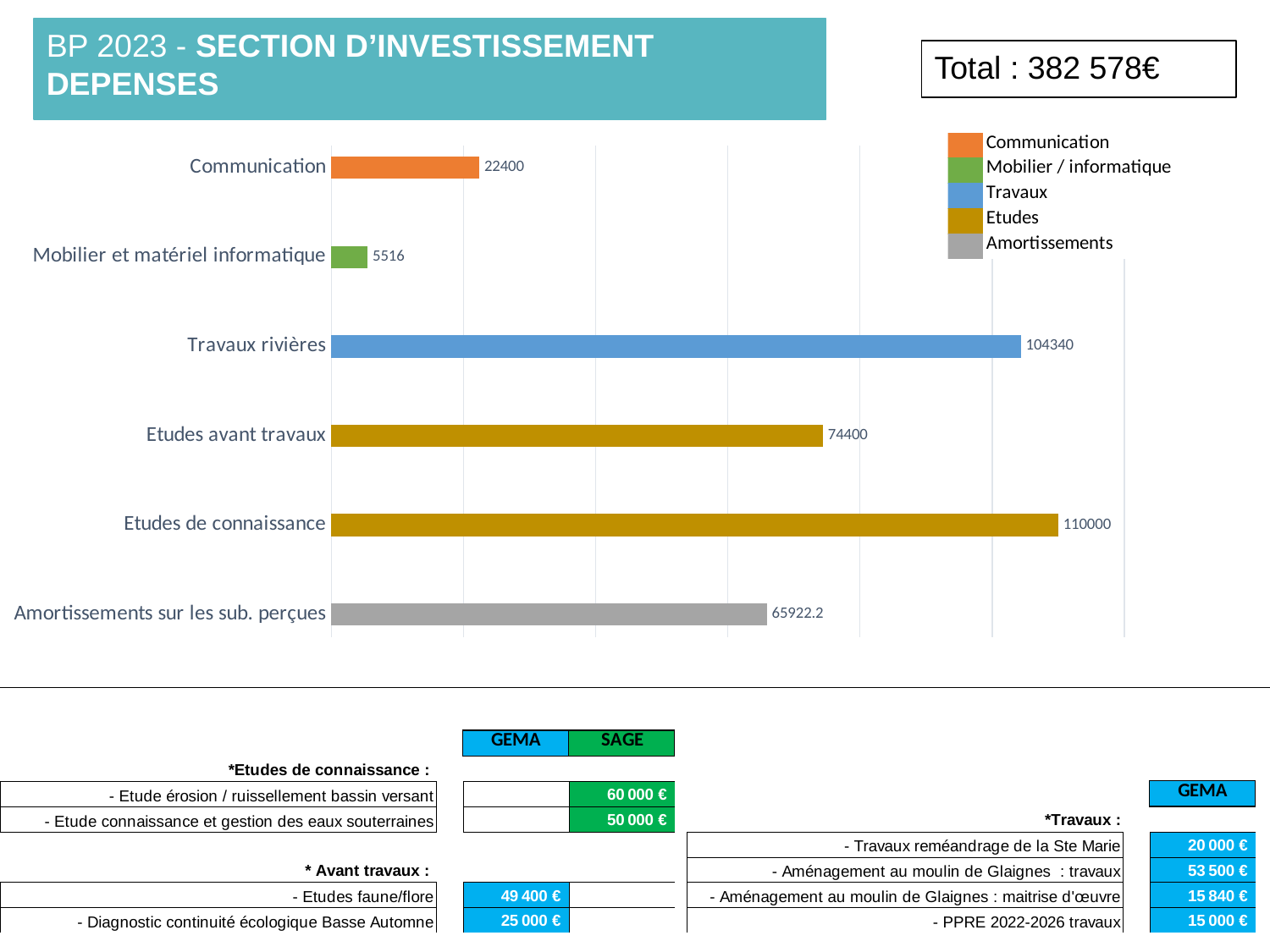
What is the value for Travaux rivières? 104340 What is the value for Communication? 22400 Which is larger, Travaux rivières or Etudes avant travaux? Travaux rivières What is the difference between Etudes de connaissance and Travaux rivières? 5660 Which category has the lowest value? Mobilier et matériel informatique What kind of chart is shown on the slide? bar chart How many categories are shown in the bar chart? 6 How many entries does the legend list? 5 Which category has the highest value? Etudes de connaissance What colour does the legend assign to Travaux? blue What is the difference between Communication and Mobilier et matériel informatique? 16884 What is the value for Amortissements sur les sub. perçues? 65922.2